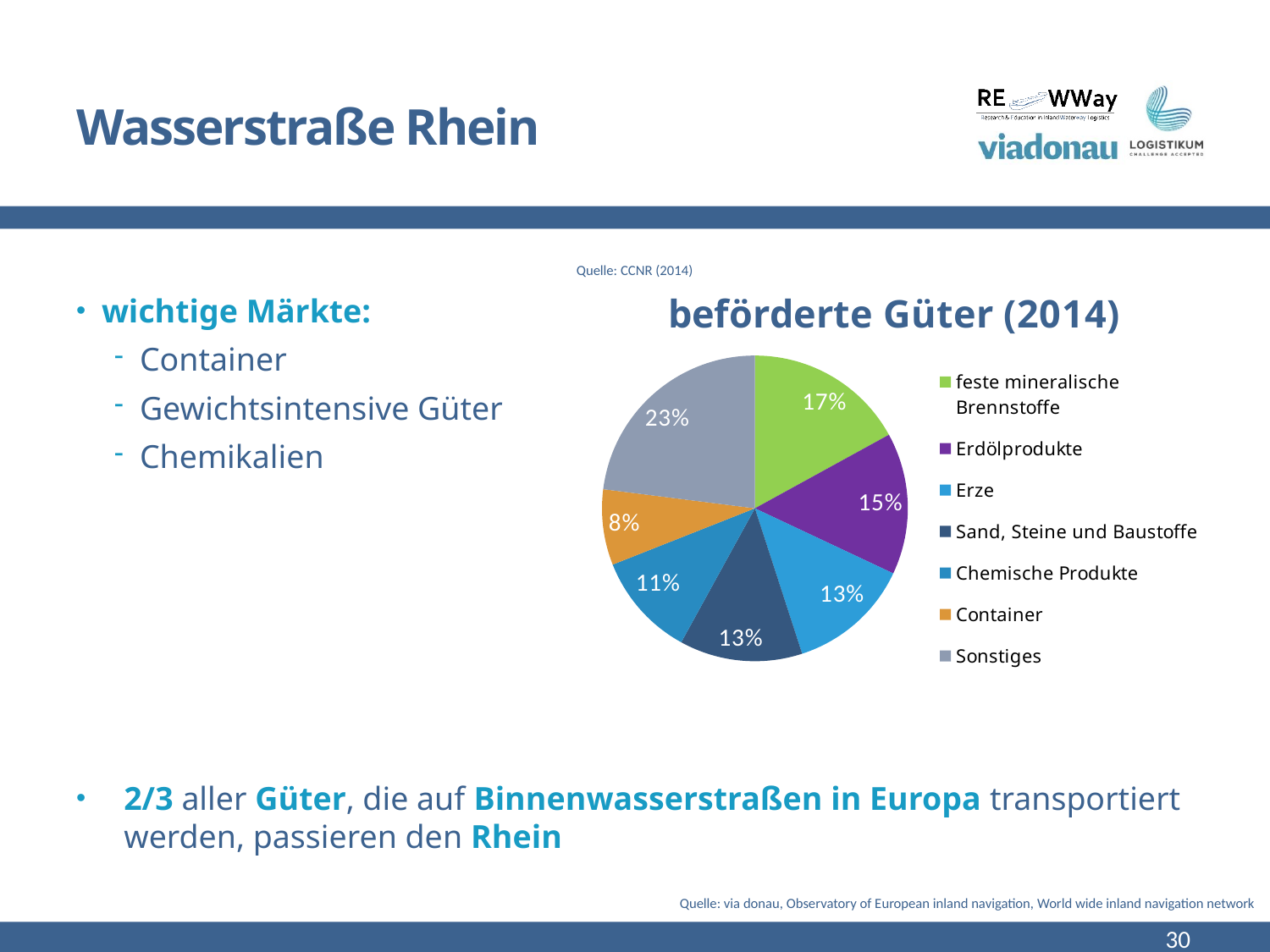
What share of the pie does feste mineralische Brennstoffe have? 17% Which category has the smallest share of the pie? Container Which is larger, the share for Erdölprodukte or the share for Chemische Produkte? Erdölprodukte Which colour represents Container in the pie chart? orange Which category has the largest share of the pie? Sonstiges What kind of chart is shown on the slide? pie chart What is the difference in percentage points between Sonstiges and Container? 15 What share of the pie does Container have? 8% How many categories does the legend list? 7 What share of the pie does Erdölprodukte have? 15% What is the title of the chart? beförderte Güter (2014) What share of the pie does Chemische Produkte have? 11%